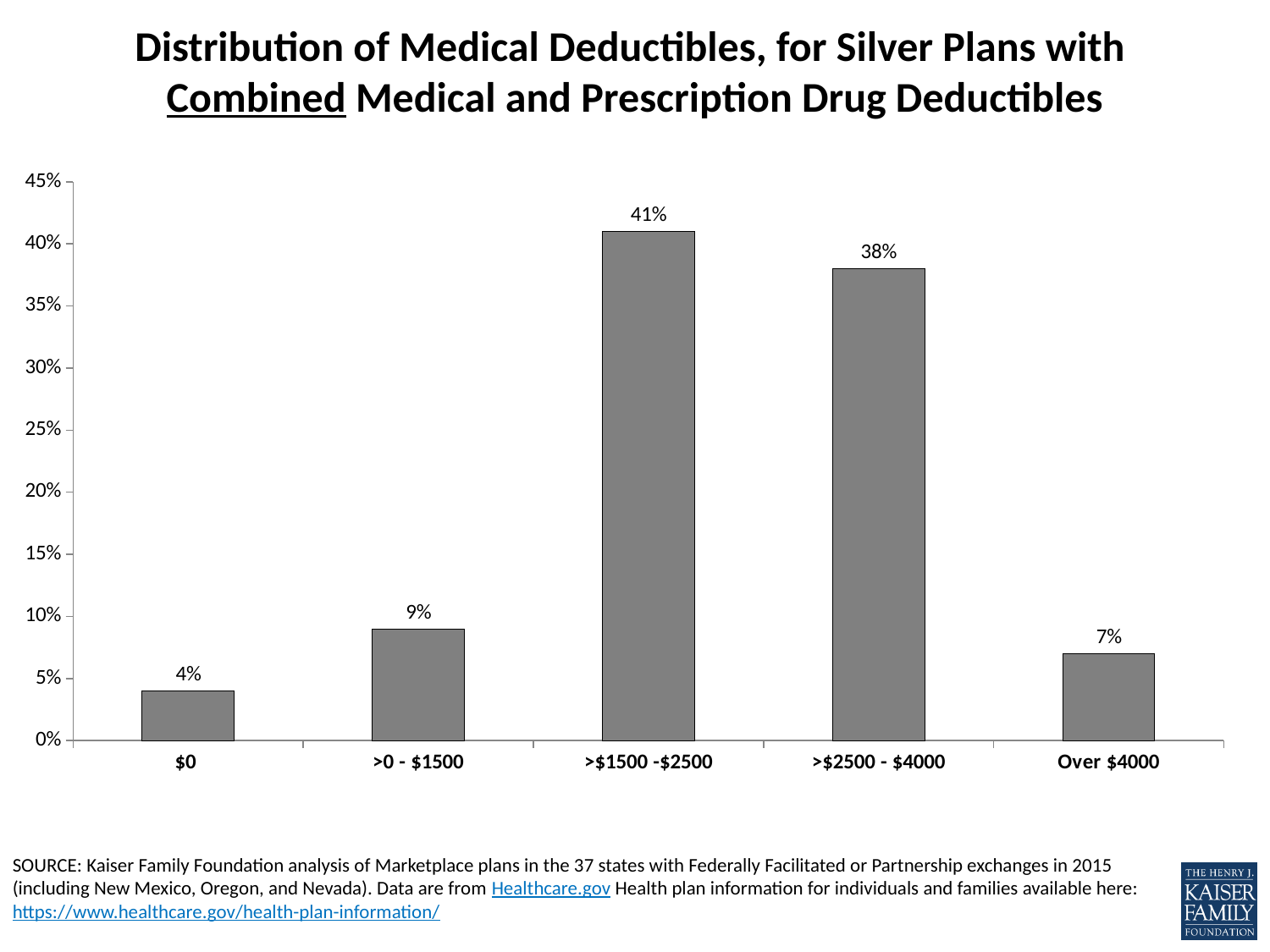
Which deductible range has the lowest share of plans? $0 What percentage of plans fall in the "Over $4000" category? 7% What kind of chart is shown on the slide? Bar chart What is the highest value shown on the vertical axis? 45% What is the value shown for the ">$1500 -$2500" deductible range? 41% Which deductible range has the highest share of plans? >$1500 -$2500 Is the value for ">$2500 - $4000" greater or less than 35%? greater What percentage of silver plans with combined deductibles have a medical deductible of $0? 4% How many deductible categories are shown on the chart? 5 What is the difference in percentage points between the ">$1500 -$2500" and ">$2500 - $4000" categories? 3 percentage points What is the combined share of plans in the ">$1500 -$2500" and ">$2500 - $4000" categories? 79% Which is larger: the share for ">0 - $1500" or the share for "Over $4000"? >0 - $1500